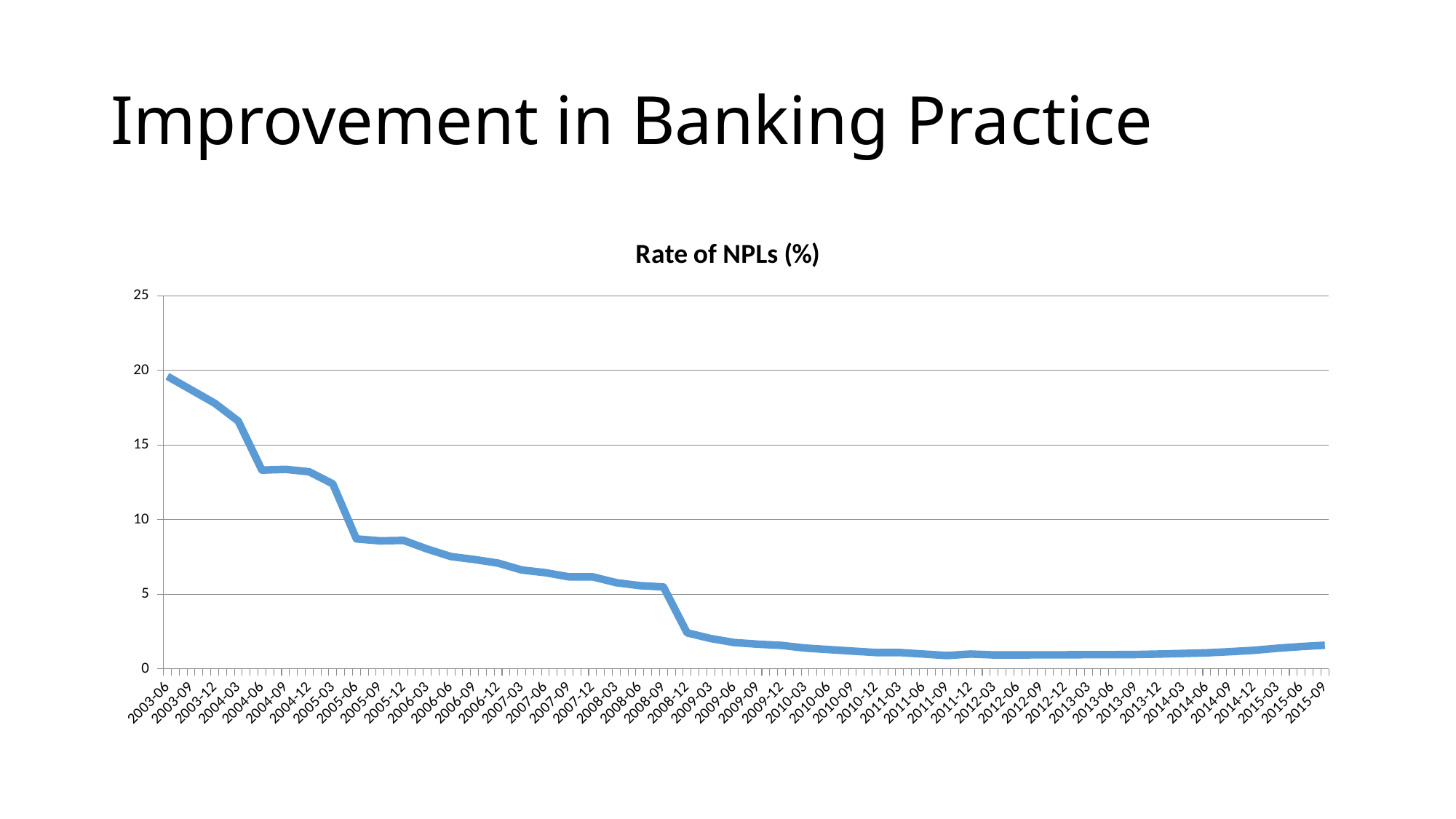
Is the value for 2008-09 greater or less than 5? greater Is the value for 2004-06 greater or less than 10? greater What kind of chart is shown on the slide? line chart Is the value for 2008-12 greater or less than 5? less Do the values generally rise or fall from 2003-06 to 2015-09? fall What is the title of the chart? Rate of NPLs (%) Which is larger, the value for 2004-03 or the value for 2009-03? 2004-03 Which period has the highest rate of NPLs? 2003-06 What colour is the line in the chart? blue